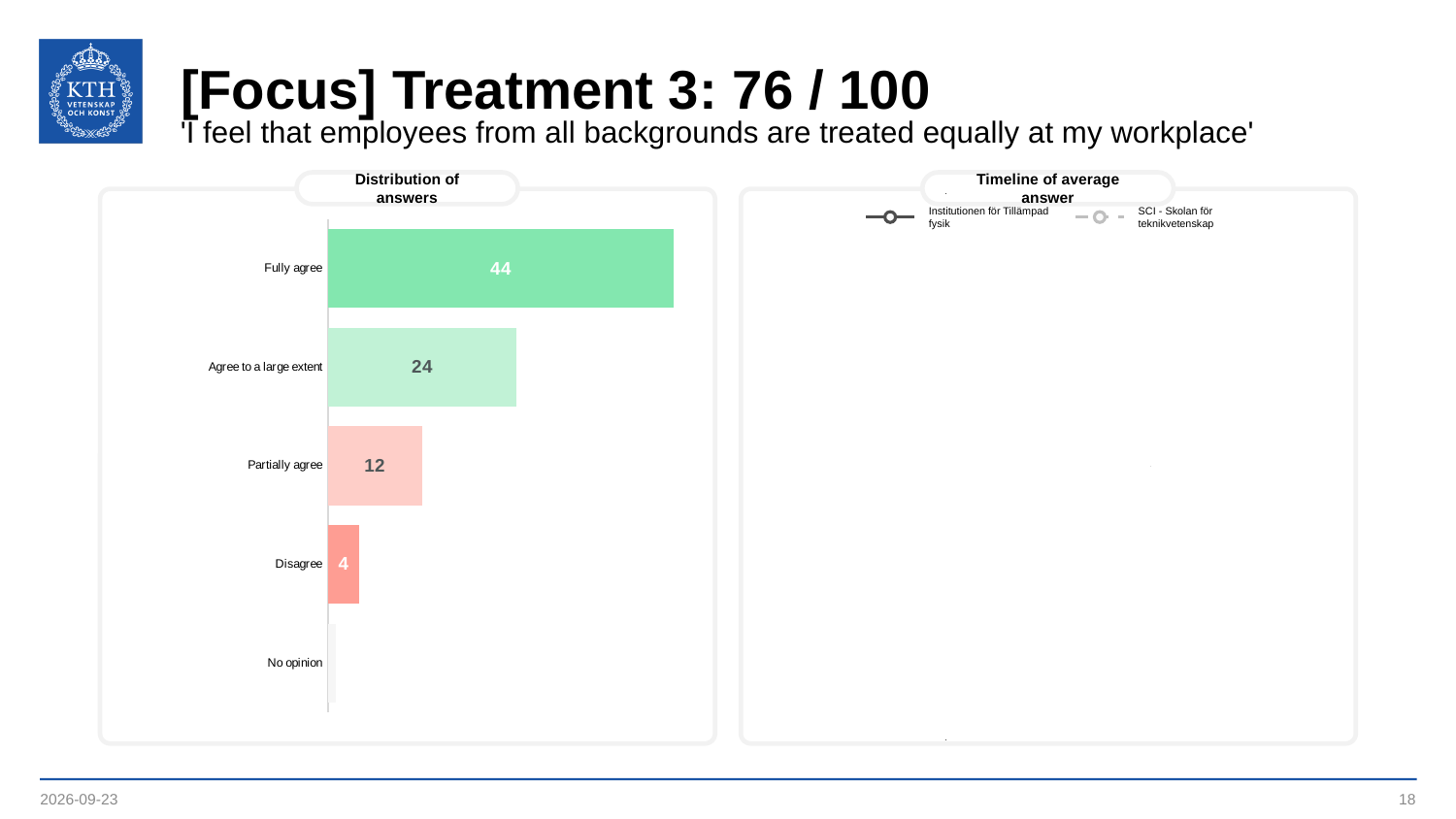
In the 'Distribution of answers' chart, what is the difference between 'Fully agree' and 'Agree to a large extent'? 20 In the 'Distribution of answers' chart, which category has the highest value? Fully agree In the 'Distribution of answers' chart, what is the value for 'Disagree'? 4 In the 'Distribution of answers' chart, what is the value for 'Partially agree'? 12 In the 'Distribution of answers' chart, what is the value for 'Agree to a large extent'? 24 In the 'Distribution of answers' chart, which is larger: 'Agree to a large extent' or 'Partially agree'? Agree to a large extent How many series does the legend of the 'Timeline of average answer' chart list? 2 What are the two legend entries in the 'Timeline of average answer' chart? Institutionen för Tillämpad fysik; SCI - Skolan för teknikvetenskap What kind of chart is the 'Distribution of answers' chart? Bar chart How many categories are shown in the 'Distribution of answers' chart? 5 In the 'Distribution of answers' chart, what is the difference between 'Partially agree' and 'Disagree'? 8 In the 'Distribution of answers' chart, what is the value for 'Fully agree'? 44